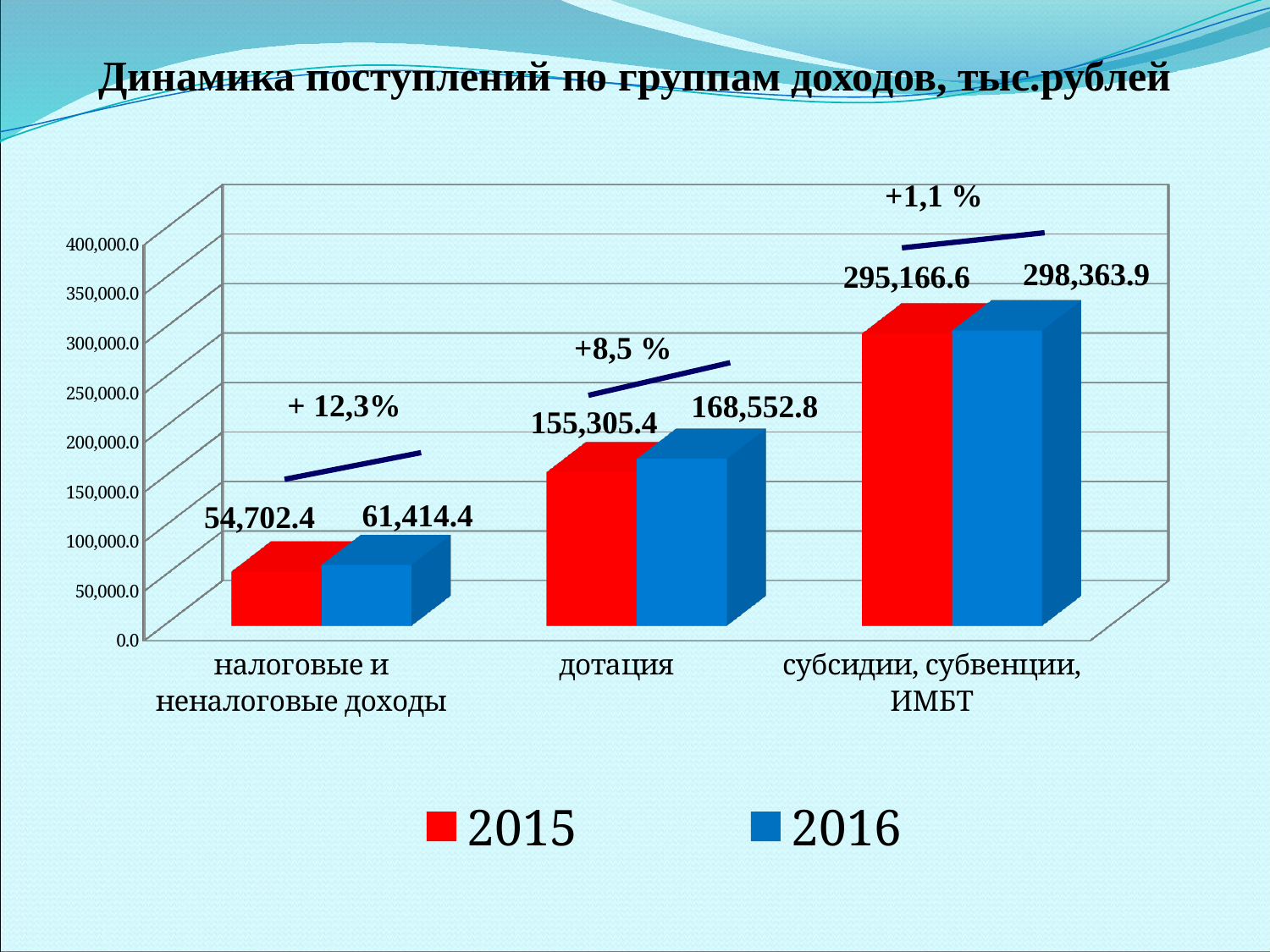
What is the 2015 value for налоговые и неналоговые доходы? 54,702.4 What is the difference between the 2016 and 2015 values for дотация? 13,247.4 What is the 2016 value for субсидии, субвенции, ИМБТ? 298,363.9 Which category has the lowest 2016 value? налоговые и неналоговые доходы What percentage change is annotated above the субсидии, субвенции, ИМБТ bars? +1,1 % Which category has the highest 2015 value? субсидии, субвенции, ИМБТ Which is larger: the 2015 value for дотация or the 2016 value for налоговые и неналоговые доходы? 2015 value for дотация How many series does the legend list? 2 What kind of chart is shown on the slide? bar chart How many categories are shown on the x axis? 3 What is the difference between the 2016 and 2015 values for налоговые и неналоговые доходы? 6,712.0 What is the 2016 value for дотация? 168,552.8